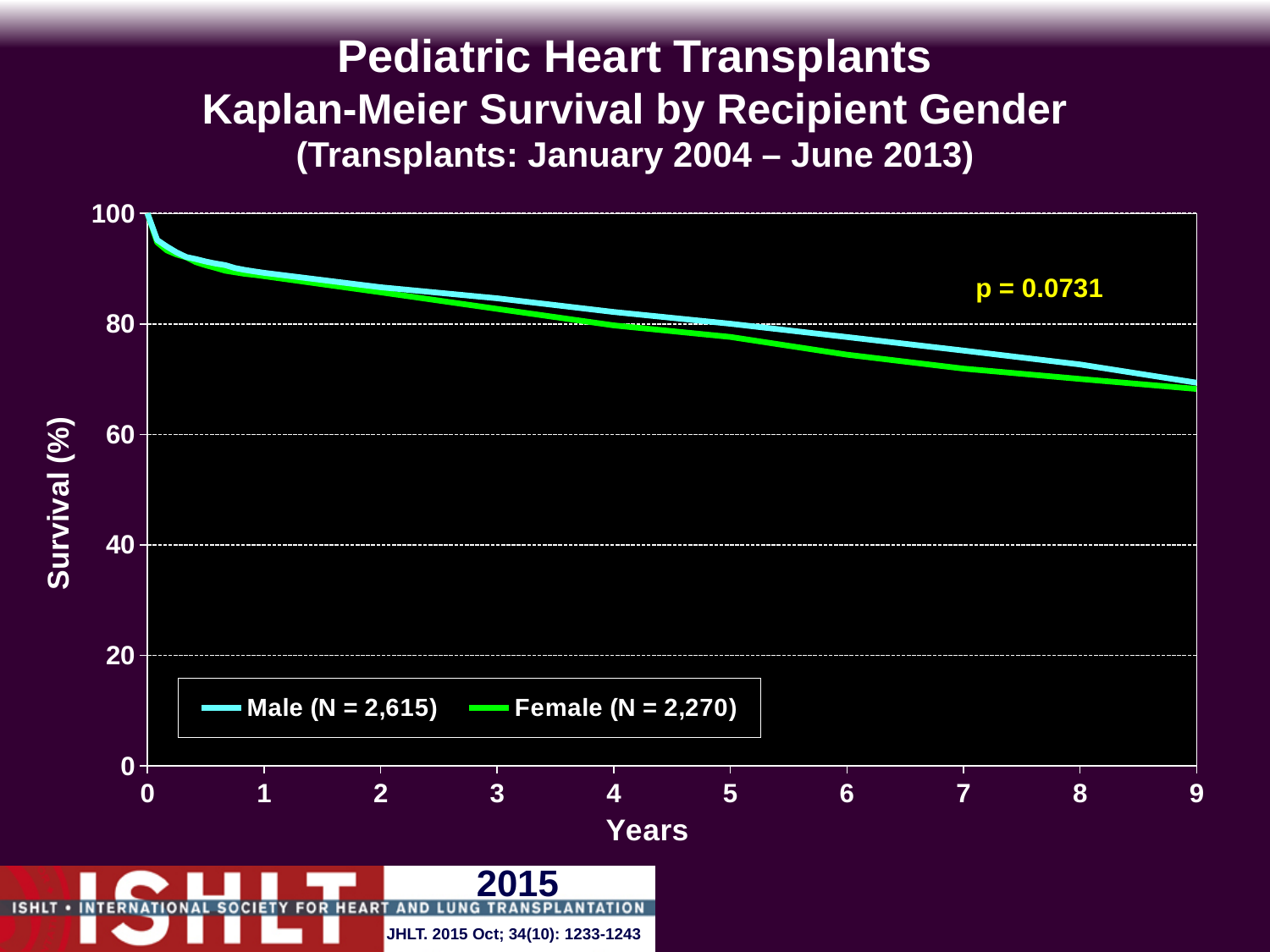
What is the label of the y axis? Survival (%) Is the Female survival at year 9 greater or less than 80? less Is the Male survival at year 9 greater or less than 60? greater How many series does the legend list? 2 At year 7, which series has the higher survival, Male or Female? Male What is the survival (%) for both series at year 0? 100 What kind of chart is shown on the slide? line chart Do the survival curves rise or fall as years increase? fall What is the N for the Male series shown in the legend? 2,615 Is the Female survival at year 1 greater or less than 80? greater What is the N for the Female series shown in the legend? 2,270 What p-value is printed on the chart? p = 0.0731